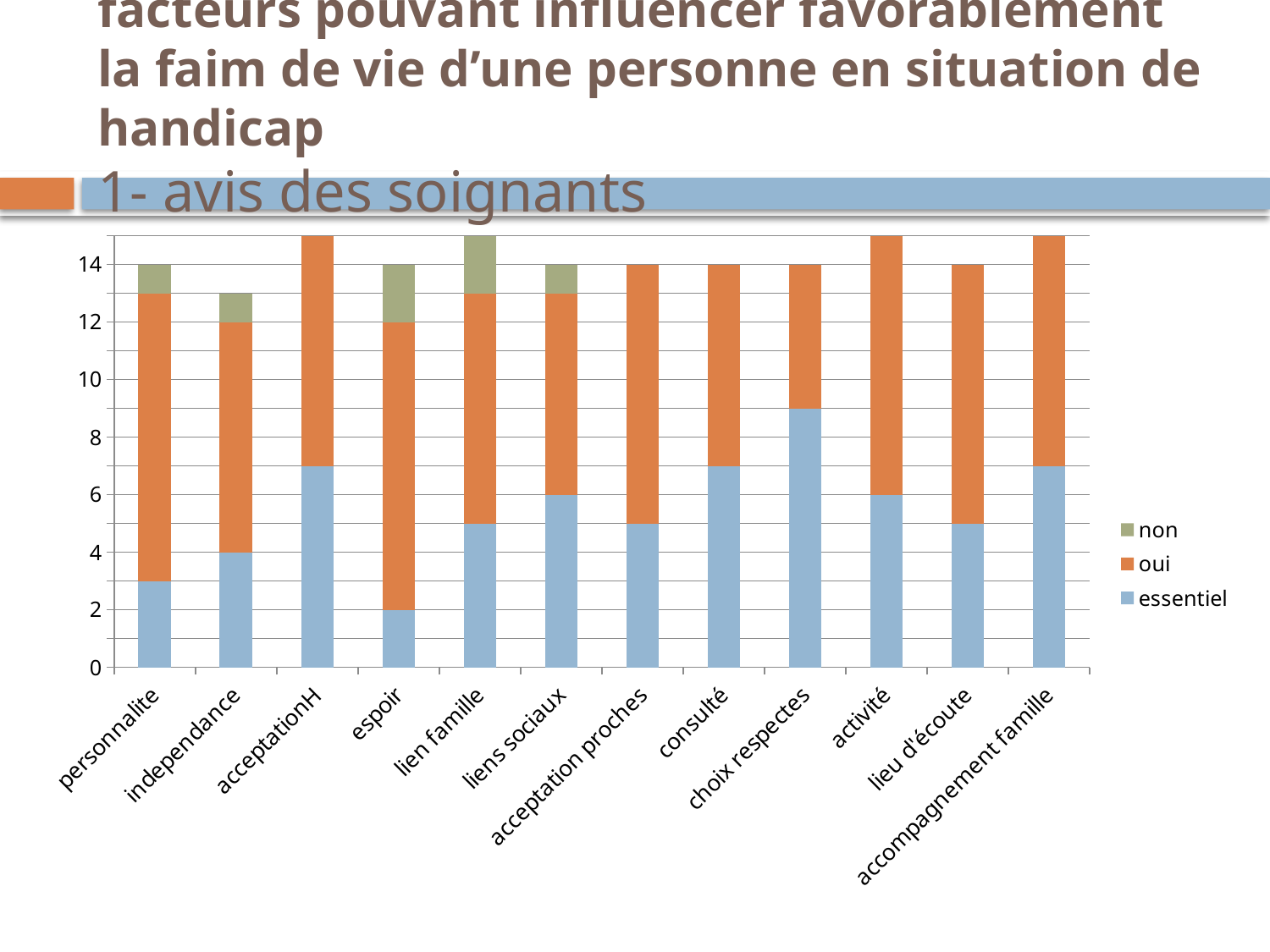
How many categories are shown on the x axis? 12 Which category has the highest 'essentiel' value? choix respectes Which has the larger 'essentiel' value, 'acceptationH' or 'independance'? acceptationH Is the 'essentiel' value for 'choix respectes' greater or less than 8? greater Is the 'essentiel' value for 'personnalite' greater or less than 4? less Which category has the lowest 'essentiel' value? espoir What kind of chart is shown on the slide? stacked bar chart What is the value of the 'essentiel' series for 'liens sociaux'? 6 What are the three series named in the legend? non, oui, essentiel What is the total height of the stacked bar for 'personnalite'? 14 How many series does the legend list? 3 What is the value of the 'essentiel' series for 'independance'? 4